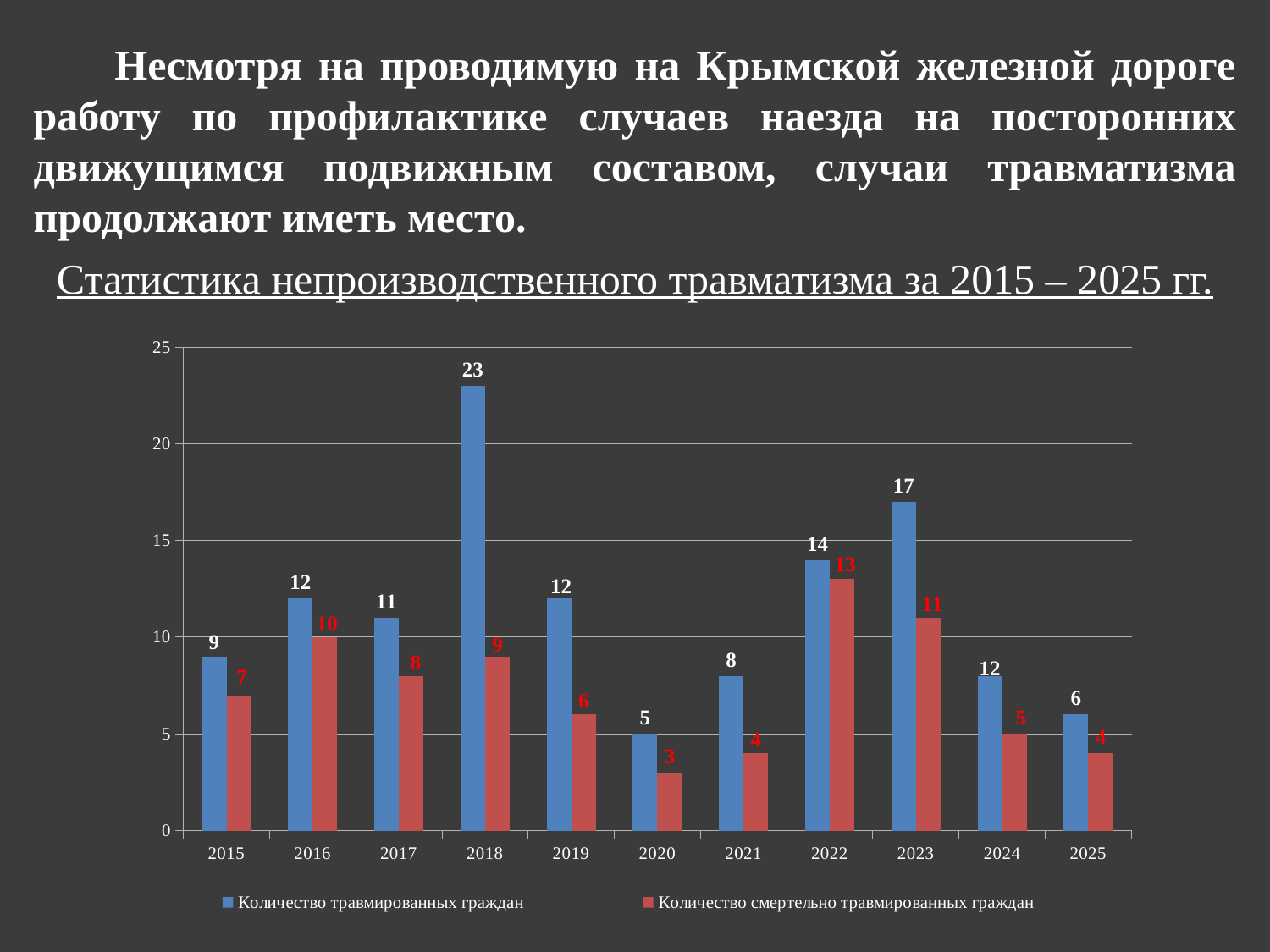
What is the difference between "Количество травмированных граждан" and "Количество смертельно травмированных граждан" in 2018? 14 In which year is "Количество смертельно травмированных граждан" the lowest? 2020 How many years are shown on the x axis of the chart? 11 What is the value of "Количество травмированных граждан" for 2018? 23 How many series does the legend list? 2 What is the value of "Количество травмированных граждан" for 2020? 5 What is the value of "Количество смертельно травмированных граждан" for 2022? 13 What is the title of the chart? Статистика непроизводственного травматизма за 2015 – 2025 гг. Which is larger: "Количество смертельно травмированных граждан" in 2016 or in 2023? 2023 What type of chart is shown on the slide? bar chart In which year is "Количество травмированных граждан" the highest? 2018 Is the value of "Количество травмированных граждан" for 2023 greater or less than 15? greater